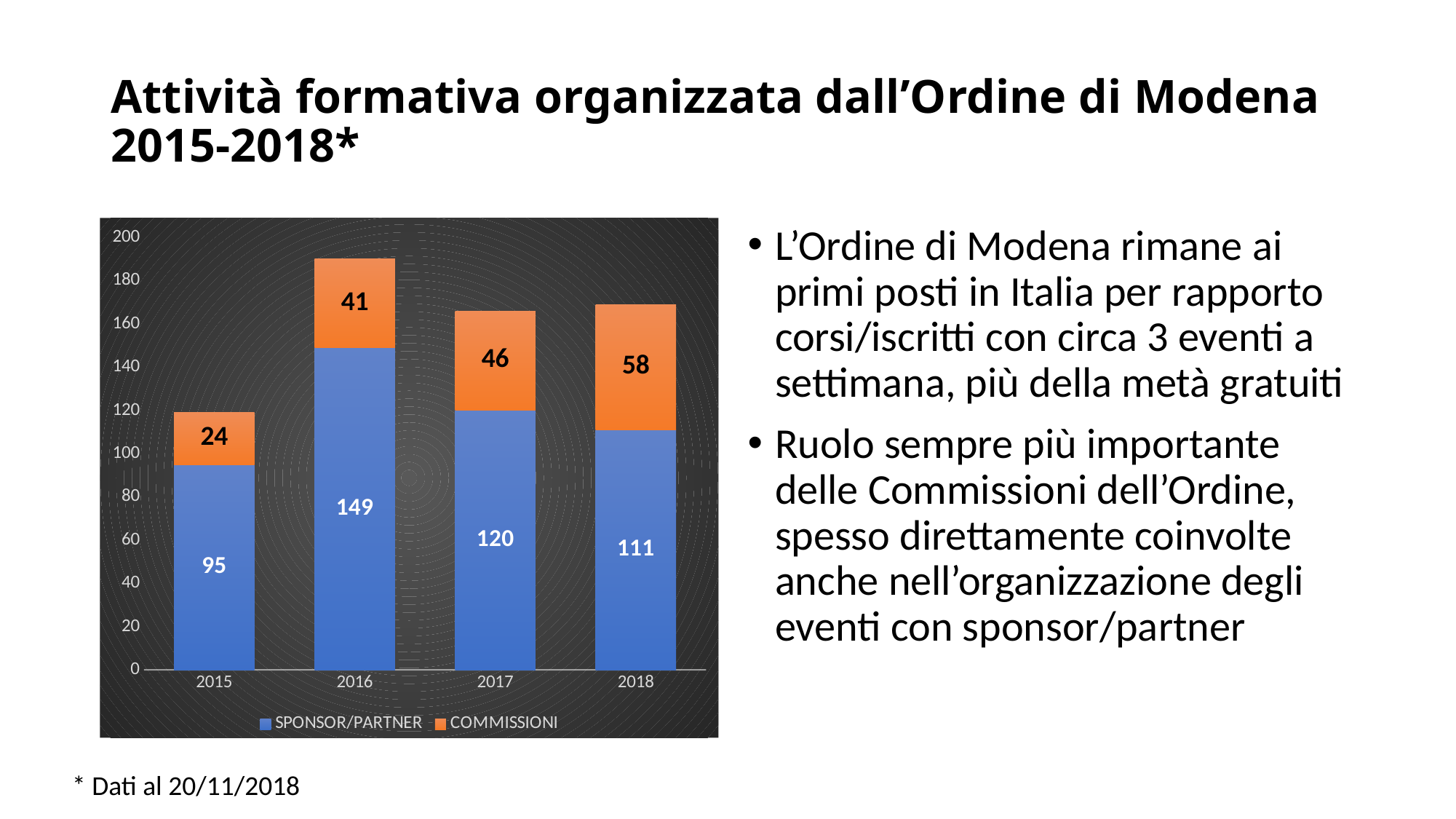
How many series does the legend list? 2 What is the COMMISSIONI value for 2018? 58 What is the total of the stacked bar for 2018? 169 What kind of chart is shown on the slide? Stacked bar chart Is the COMMISSIONI value larger in 2017 or in 2018? 2018 What is the total of the stacked bar for 2015? 119 What is the difference between the SPONSOR/PARTNER values for 2016 and 2015? 54 Which year has the highest SPONSOR/PARTNER value? 2016 What is the SPONSOR/PARTNER value for 2016? 149 How many years are shown on the x axis? 4 Which year has the lowest COMMISSIONI value? 2015 What is the SPONSOR/PARTNER value for 2015? 95